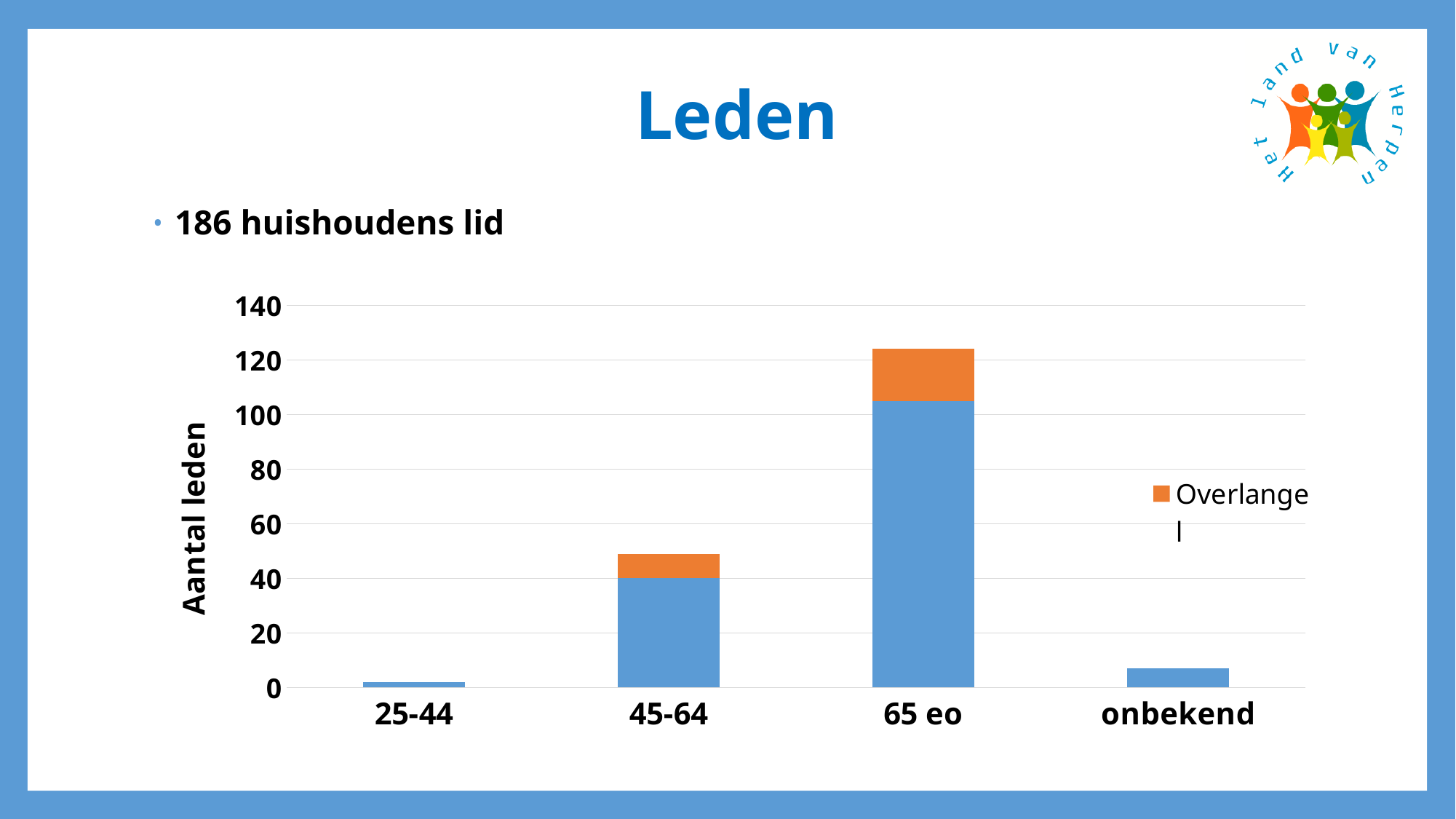
What is the title of the vertical axis of the chart? Aantal leden Is the total value for 65 eo greater or less than 100? greater Is the total value for 45-64 greater or less than 60? less Which bar is taller, 45-64 or onbekend? 45-64 What colour is the Overlangel series in the chart? orange Which category has the tallest bar in the chart? 65 eo Is the value for 25-44 greater or less than 20? less Which category has the shortest bar in the chart? 25-44 How many categories have an orange segment in their bar? 2 What kind of chart is shown on the slide? bar chart How many categories are shown on the x axis of the chart? 4